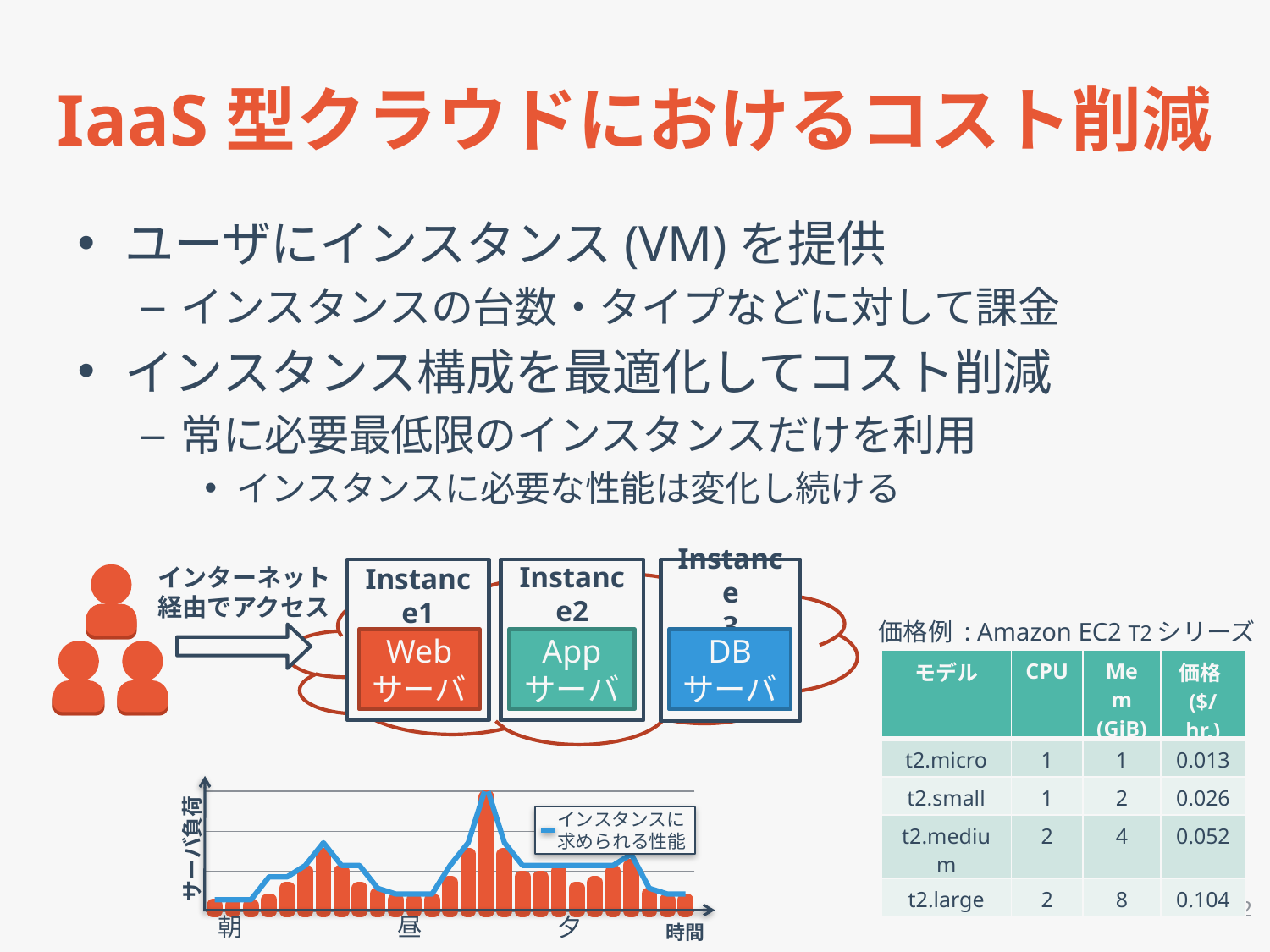
How many time-of-day labels (朝, 昼, 夕) are shown along the x axis of the bottom-left chart? 3 How many series does the legend of the bottom-left chart list? 1 What is the label of the vertical axis of the bottom-left chart? サーバ負荷 In the bottom-left chart, does the server load rise or fall from 朝 toward the first peak? rise In the bottom-left chart, is the highest peak of server load located between 朝 and 昼 or between 昼 and 夕? between 昼 and 夕 What is the legend entry of the bottom-left chart? インスタンスに求められる性能 What kind of chart is shown at the bottom left of the slide? combination bar and line chart In the bottom-left chart, does the server load rise or fall from the tallest peak toward 夕? fall